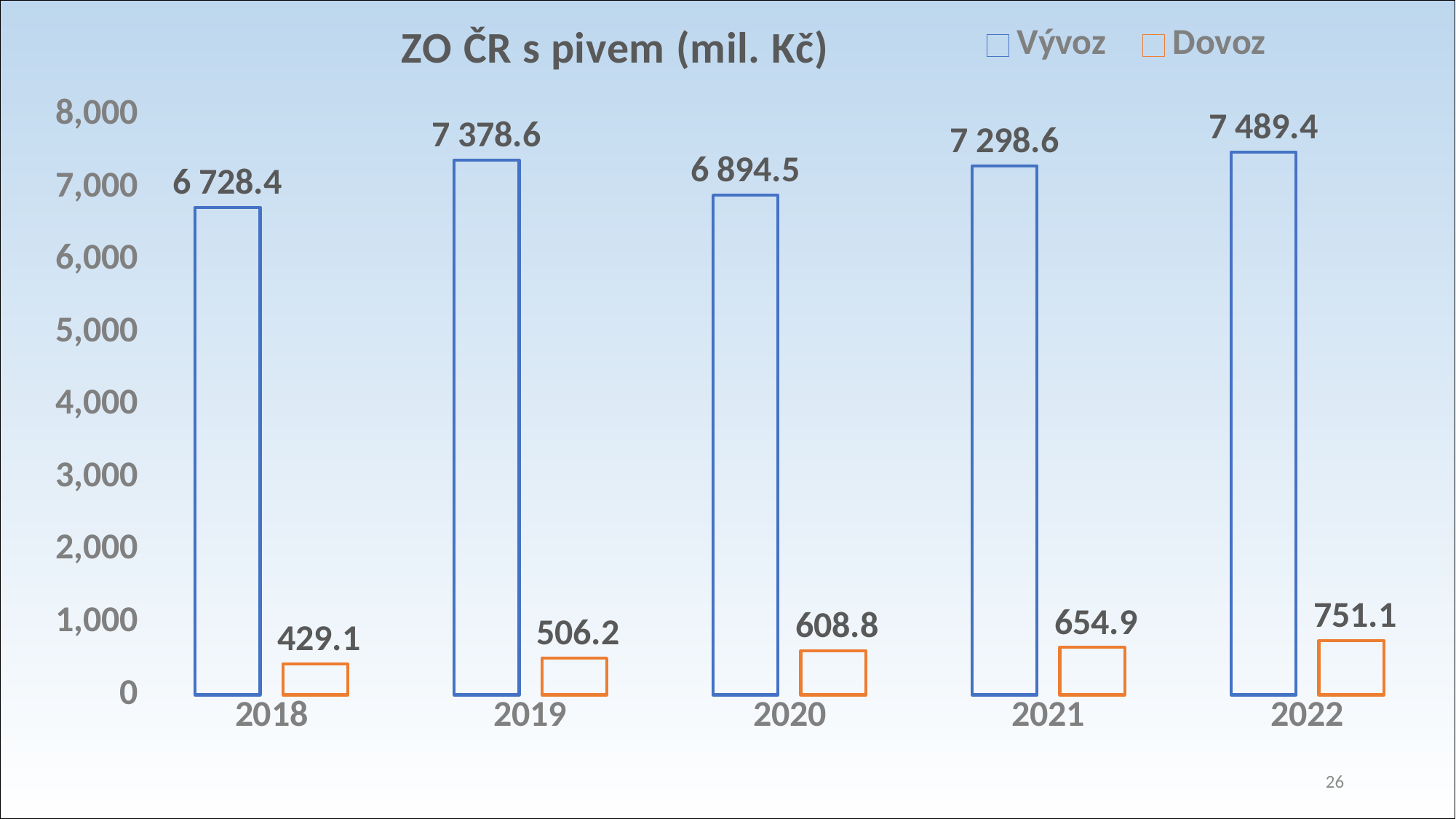
Is the Vývoz value for 2018 greater or less than 7,000? less Which year has the highest Vývoz value? 2022 How many years are shown on the x axis? 5 What is the Vývoz value for 2019? 7 378.6 Do the Dovoz values rise or fall from 2018 to 2022? rise Which year has the lowest Dovoz value? 2018 What is the difference between the Dovoz values for 2022 and 2018? 322.0 What kind of chart is shown? bar chart What is the Dovoz value for 2021? 654.9 Which is larger, the Vývoz value for 2019 or for 2021? 2019 How many series does the legend list? 2 What is the Vývoz value for 2020? 6 894.5